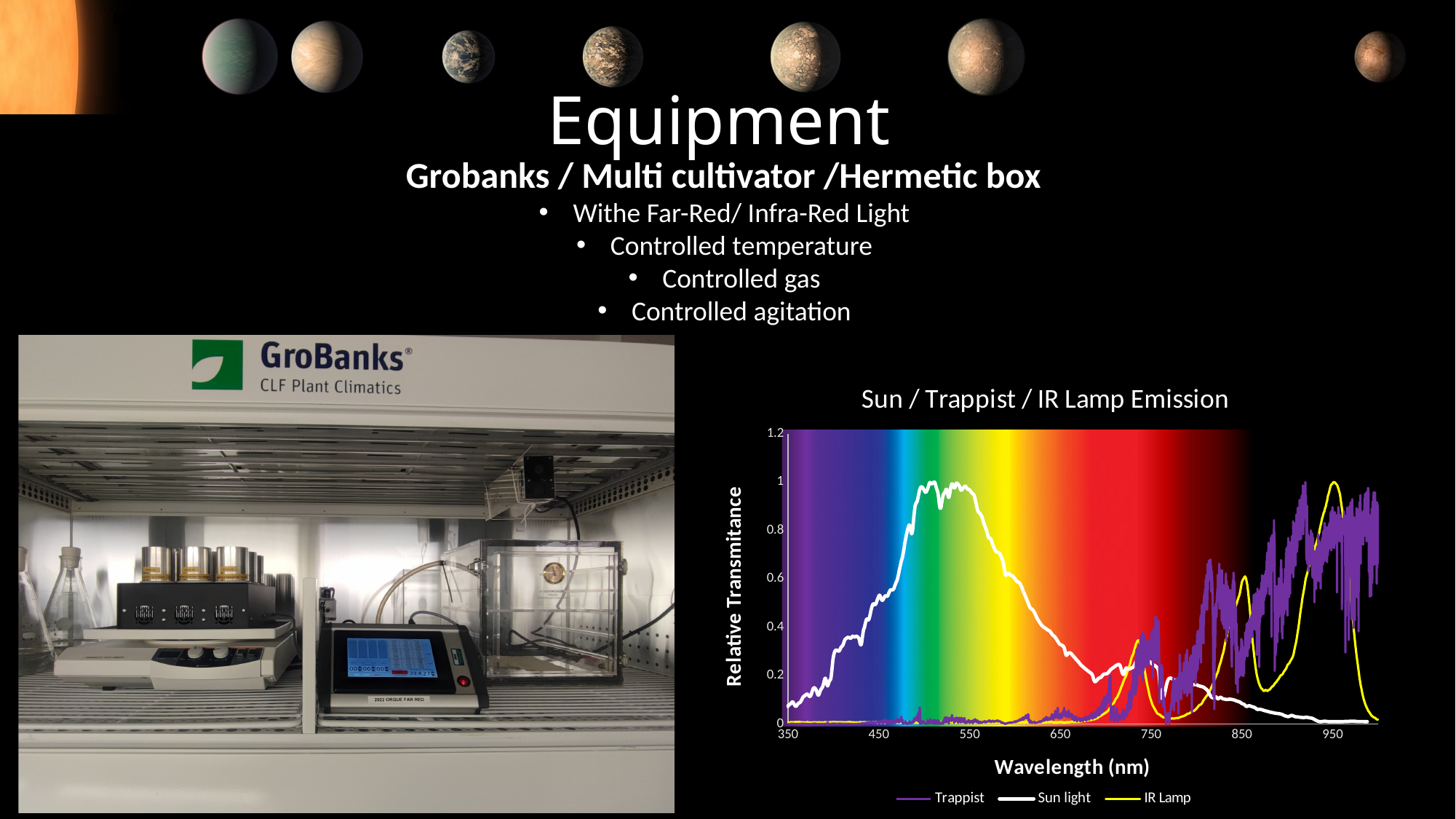
What is the title of the chart? Sun / Trappist / IR Lamp Emission How many series does the chart legend list? 3 What kind of chart is shown on the slide? Line chart What is the label of the x axis of the chart? Wavelength (nm) Does the Sun light series rise or fall between 550 nm and 950 nm? Fall Is the Sun light value at 550 nm greater or less than 0.8? greater Which series reaches its peak at the shortest wavelength? Sun light At 550 nm, which series has the larger value, Sun light or Trappist? Sun light Is the Trappist value at 450 nm greater or less than 0.2? less Is the IR Lamp value at 550 nm greater or less than 0.2? less At 950 nm, which series has the larger value, IR Lamp or Sun light? IR Lamp